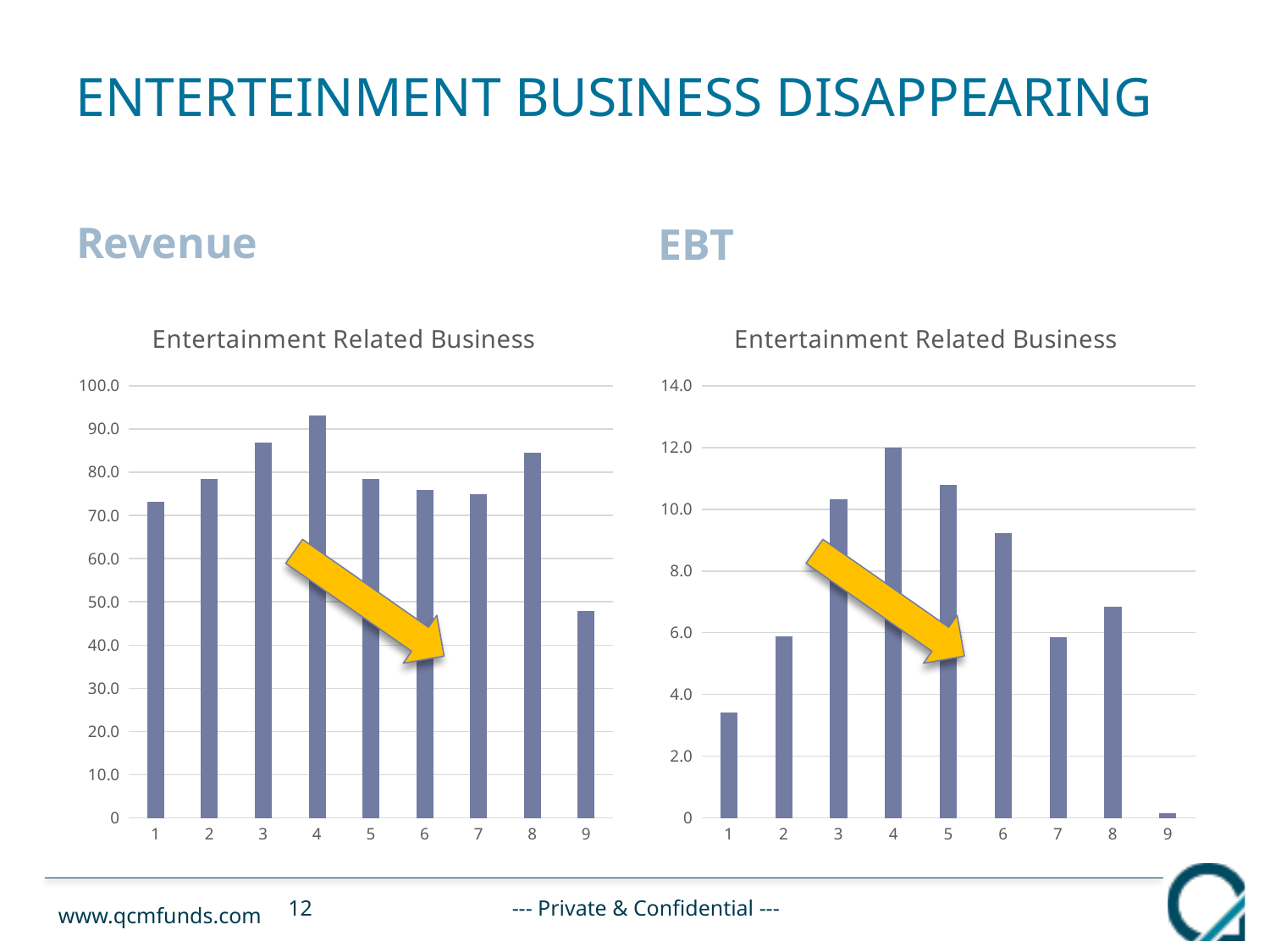
In the EBT chart on the right, which category has the highest bar? 4 What is the title printed above the EBT chart on the right? Entertainment Related Business How many categories are shown on the x axis of the EBT chart on the right? 9 In the Revenue chart on the left, which category has the lowest bar? 9 In the Revenue chart on the left, which category has the highest bar? 4 In the EBT chart on the right, which category has the lowest bar? 9 What kind of chart is the Revenue chart on the left? bar chart In the Revenue chart on the left, is the value for category 9 greater or less than 50.0? less In the EBT chart on the right, is the value for category 1 greater or less than 4.0? less In the EBT chart on the right, which is larger, the value for category 3 or the value for category 7? 3 In the Revenue chart on the left, is the value for category 4 greater or less than 90.0? greater In the Revenue chart on the left, do the values rise or fall from category 4 to category 7? fall